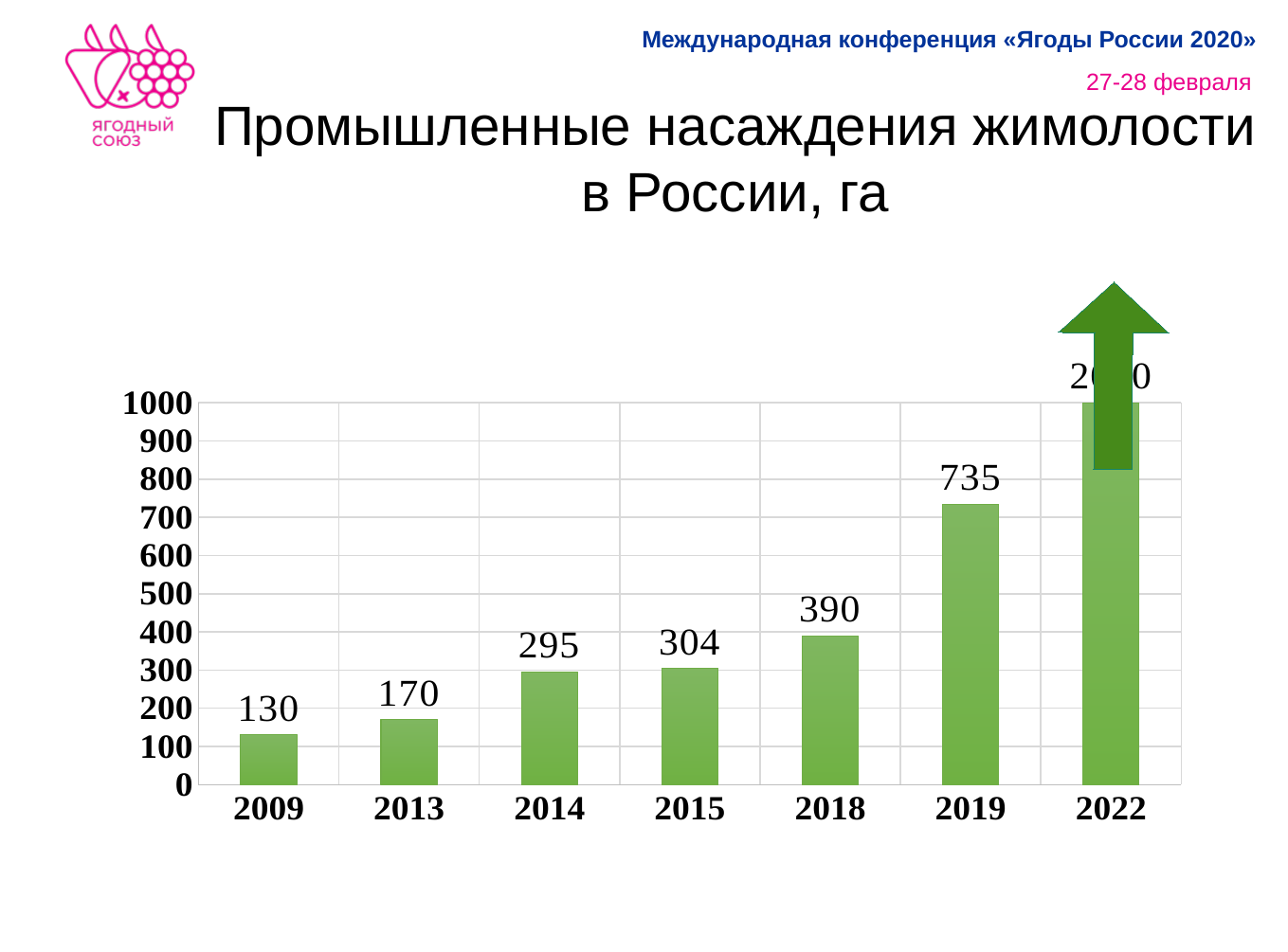
What is the value for 2009? 130 What is the value for 2019? 735 What is the value for 2014? 295 Is the value for 2019 greater or less than 700? greater What is the difference between the values for 2019 and 2018? 345 What kind of chart is shown on the slide? bar chart What is the value for 2018? 390 Which is larger, the value for 2014 or the value for 2015? 2015 Which year has the highest bar? 2022 Do the values rise or fall from 2009 to 2022? rise Which year has the lowest value? 2009 How many years are shown on the x axis? 7